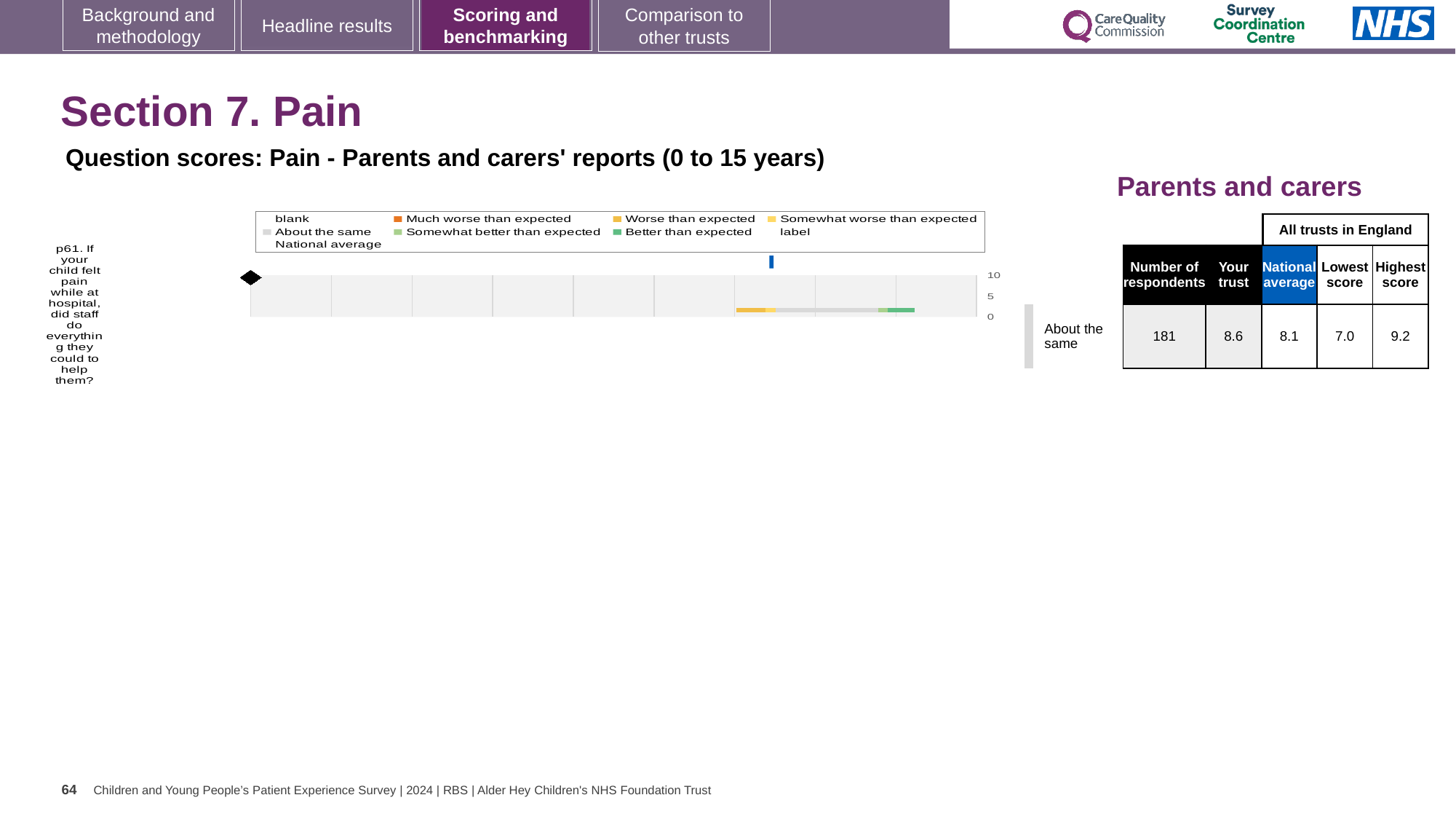
What is the highest value shown on the chart's axis? 10 What is the national average score for p61 in the table next to the chart? 8.1 Which is larger for p61: the 'Your trust' score or the national average? Your trust Which legend entry is shown in orange? Much worse than expected What is the lowest score among all trusts in England for p61? 7.0 What is the number of respondents for p61 shown in the table? 181 What is the highest score among all trusts in England for p61? 9.2 What is the question number of the item plotted in the chart? p61 How many survey questions (categories) are plotted in the chart? 1 What kind of chart is shown on the slide? bar chart What is the 'Your trust' score for p61 in the table next to the chart? 8.6 Is the national average marker for p61 positioned greater or less than 5 on the axis? greater